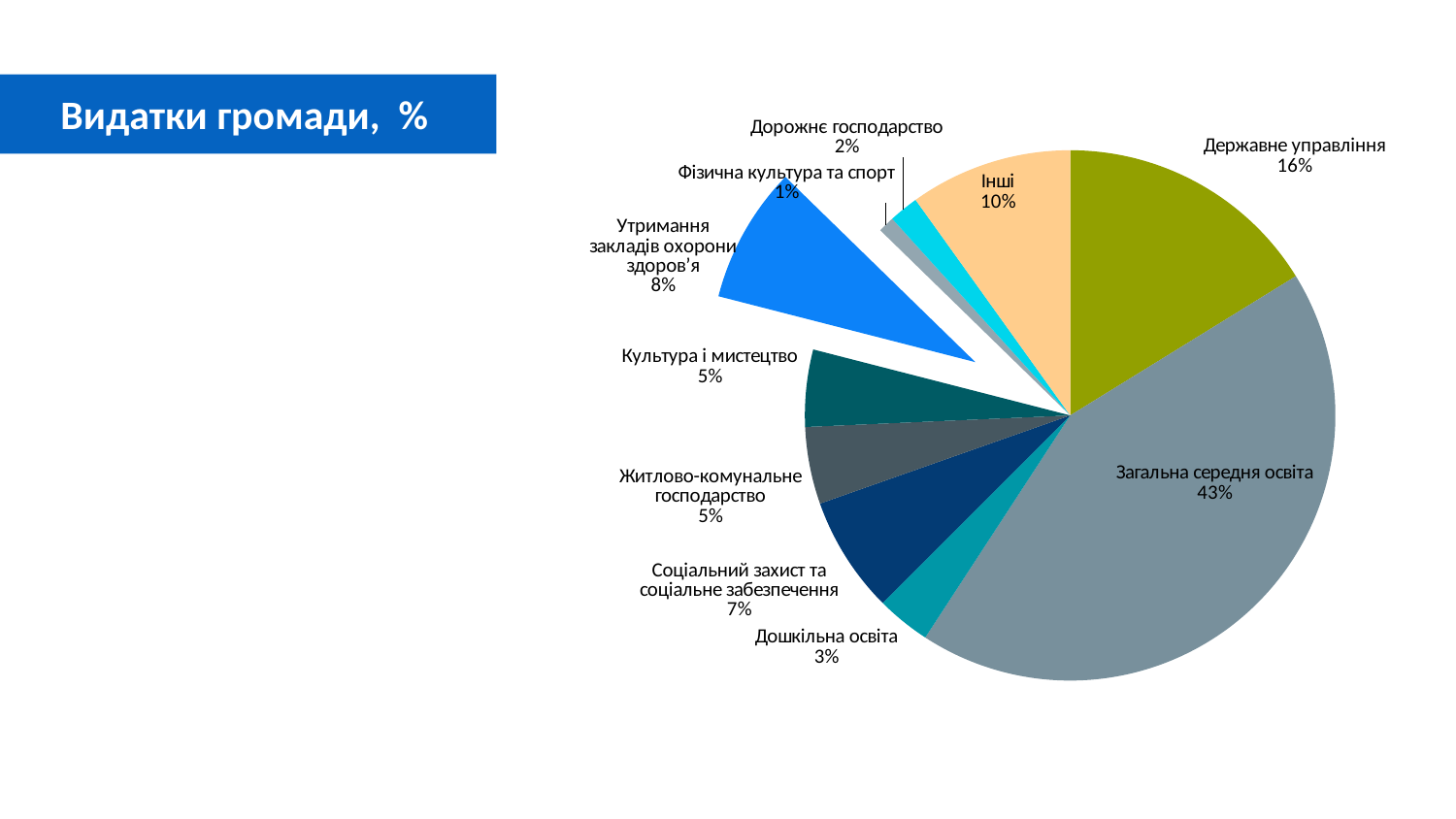
What is the value shown for "Державне управління"? 16% How many categories are shown in the pie chart? 10 What kind of chart is shown on the slide? pie chart What share of the pie does "Загальна середня освіта" have? 43% Which is larger, the share for "Соціальний захист та соціальне забезпечення" or the share for "Дошкільна освіта"? Соціальний захист та соціальне забезпечення Which category has the smallest slice of the pie? Фізична культура та спорт What is the value shown for "Інші"? 10% Which category has the largest slice of the pie? Загальна середня освіта What is the value shown for "Утримання закладів охорони здоров'я"? 8% What is the title of the chart on the slide? Видатки громади, % What is the value shown for "Дорожнє господарство"? 2% What is the difference between the shares of "Загальна середня освіта" and "Державне управління"? 27%